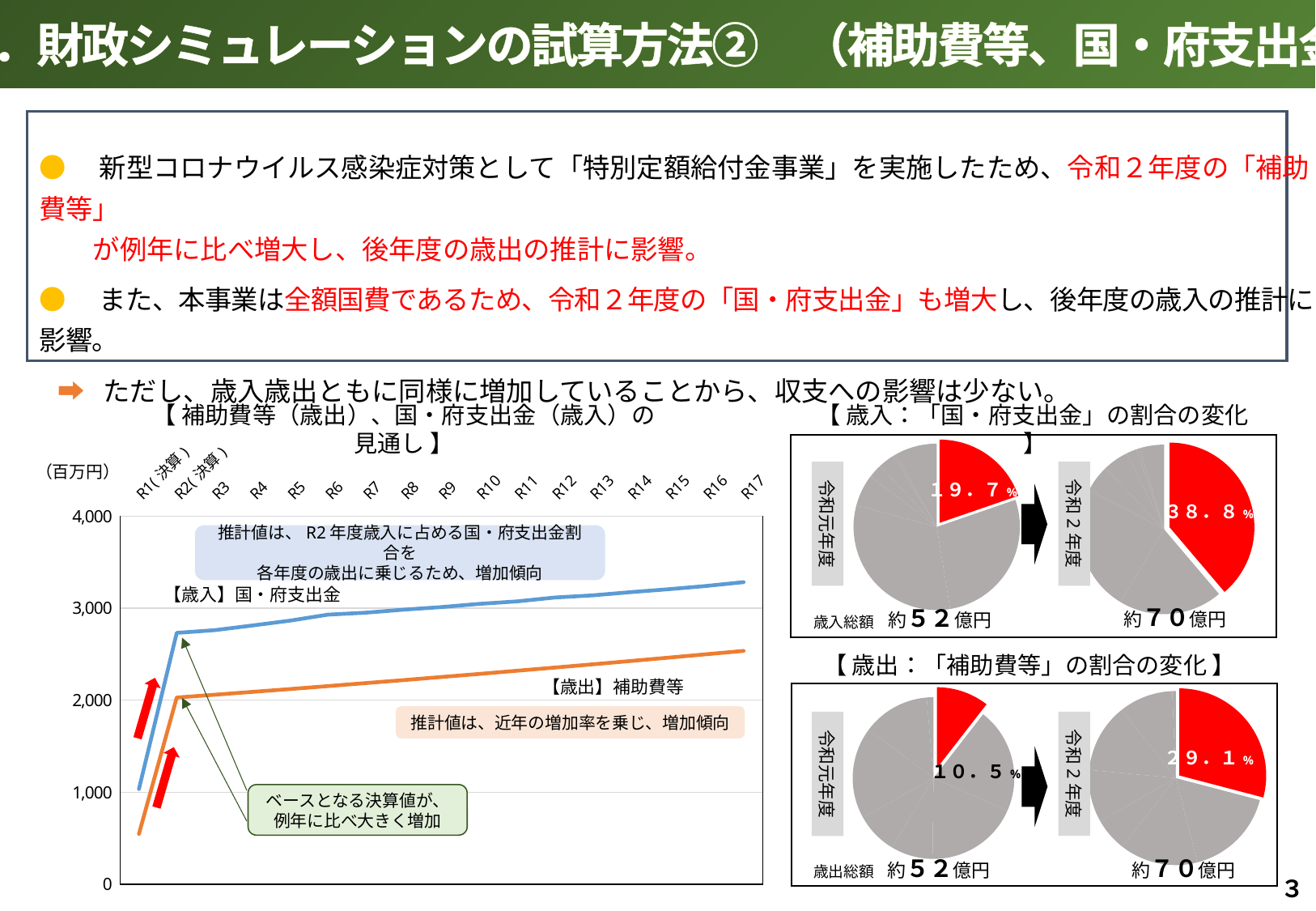
What kind of chart is the chart on the left titled 【補助費等（歳出）、国・府支出金（歳入）の見通し】? line chart In the line chart on the left, which series is higher at R17, 【歳入】国・府支出金 or 【歳出】補助費等? 【歳入】国・府支出金 In the line chart on the left, is the value for 【歳入】国・府支出金 at R17 greater or less than 3,000? greater In the line chart on the left, how many series are plotted? 2 In the line chart on the left, is the value for 【歳出】補助費等 at R1(決算) greater or less than 1,000? less In the line chart on the left, do the values for 【歳入】国・府支出金 rise or fall from R2 to R17? rise In the pie charts titled 【歳入：「国・府支出金」の割合の変化】, what is the 歳入総額 shown for 令和2年度? 約70億円 In the pie charts titled 【歳入：「国・府支出金」の割合の変化】, what share does 国・府支出金 have in 令和2年度? 38.8% In the pie charts titled 【歳入：「国・府支出金」の割合の変化】, what share does 国・府支出金 have in 令和元年度? 19.7% In the pie charts titled 【歳出：「補助費等」の割合の変化】, what share does 補助費等 have in 令和元年度? 10.5% In the line chart on the left, how many fiscal years (R1 to R17) are shown on the x axis? 17 In the pie charts titled 【歳出：「補助費等」の割合の変化】, by how many percentage points does the 補助費等 share in 令和2年度 (29.1%) exceed that in 令和元年度 (10.5%)? 18.6